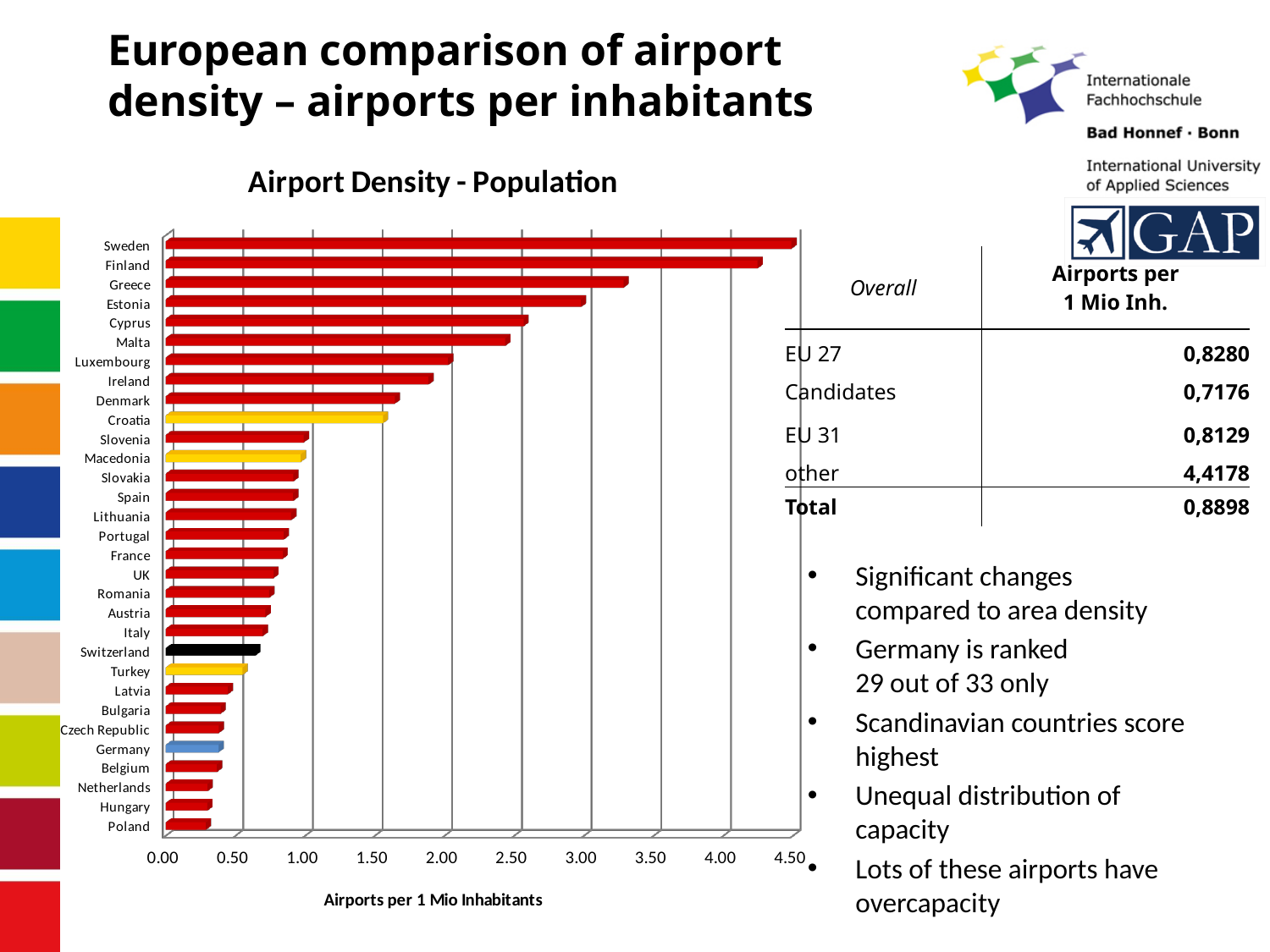
What is the label of the horizontal axis? Airports per 1 Mio Inhabitants Which has a higher value, Sweden or Finland? Sweden How many countries are plotted in the chart? 31 Is the value for Switzerland greater or less than 0.50? greater Is the value for Ireland greater or less than 2.00? less Is the value for Greece greater or less than 3.00? greater What kind of chart is shown on the slide? bar chart What is the title of the chart? Airport Density - Population Which has a higher value, Switzerland or Germany? Switzerland Which country has the highest airport density per population in the chart? Sweden